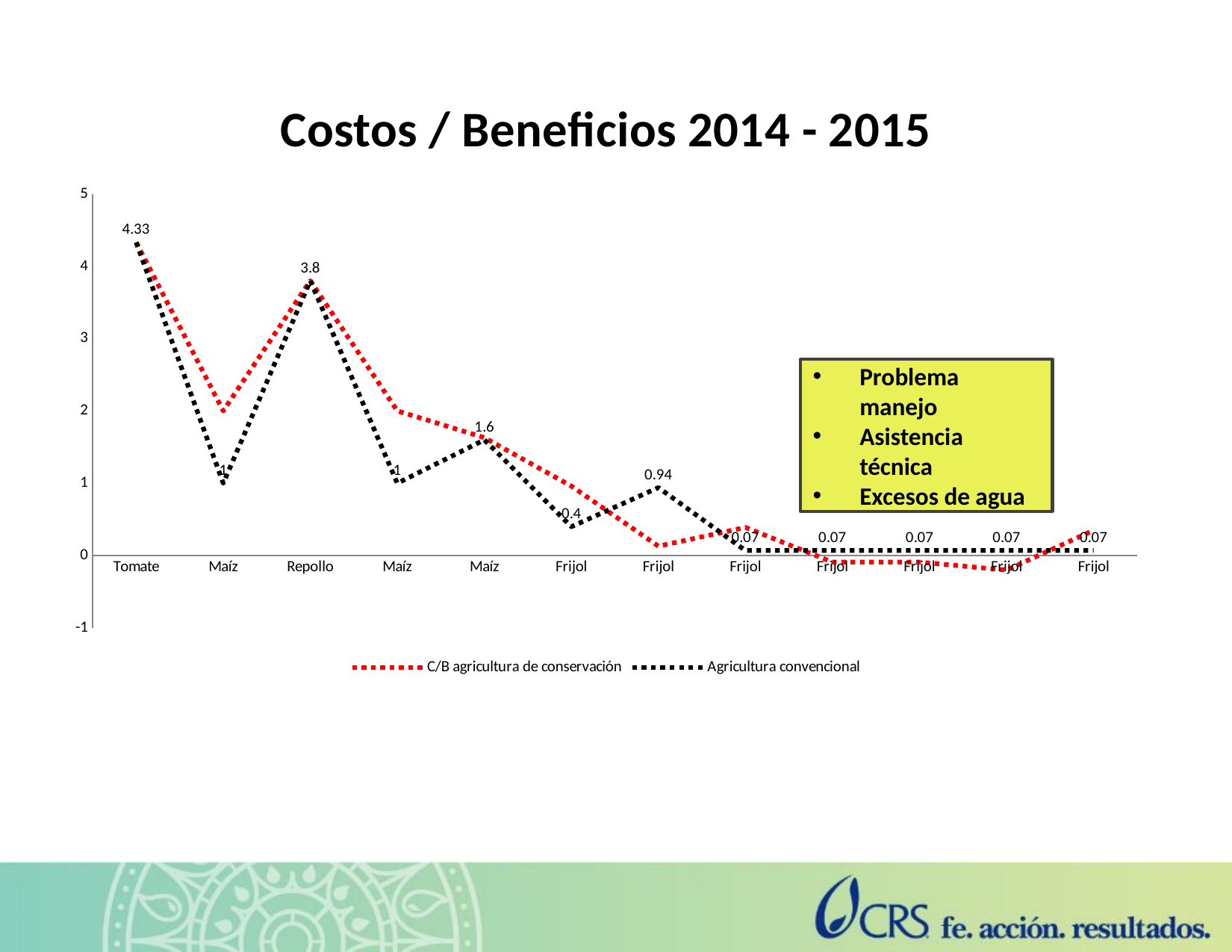
What is the value of Agricultura convencional for Tomate? 4.33 What kind of chart is shown on the slide? line chart Do the values generally rise or fall from left to right along the x axis? fall What is the value of Agricultura convencional for Repollo? 3.8 Which category has the highest value for Agricultura convencional? Tomate At the seventh category (second Frijol), which series has the higher value? Agricultura convencional What is the value of Agricultura convencional at the third Maíz category (fifth point from the left)? 1.6 What is the title of the chart? Costos / Beneficios 2014 - 2015 Is the value of C/B agricultura de conservación for Repollo greater or less than 3? greater What is the difference between the Agricultura convencional values for Tomate and Repollo? 0.53 How many categories are plotted along the x axis? 12 How many series does the legend list? 2